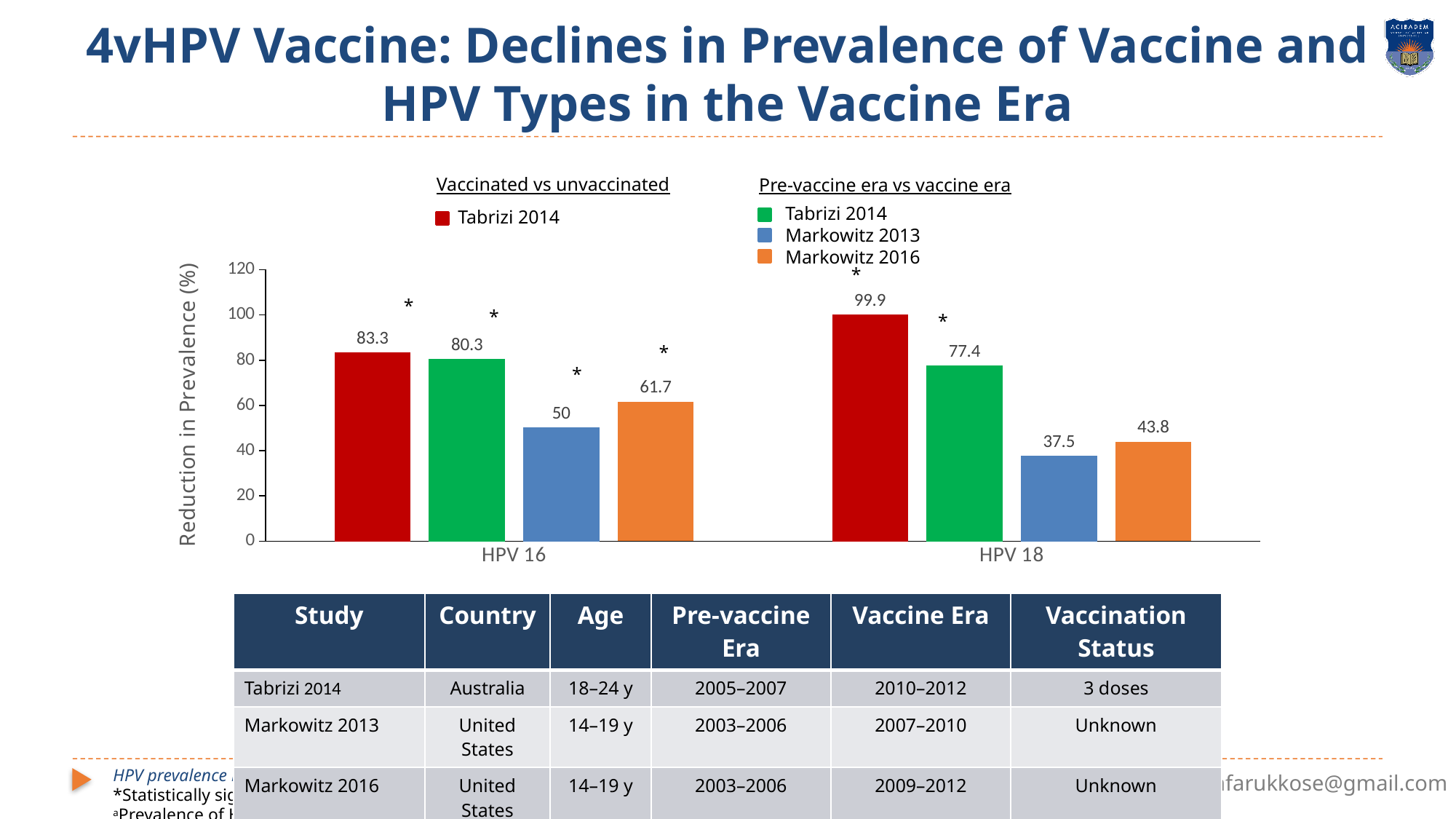
What is the reduction in prevalence for HPV 18 in the red Tabrizi 2014 (vaccinated vs unvaccinated) series? 99.9 How many categories are shown on the x axis? 2 What kind of chart is shown on the slide? bar chart What is the reduction in prevalence for HPV 16 in the Markowitz 2013 series? 50 Which series has the highest reduction in prevalence for HPV 18? Tabrizi 2014 (vaccinated vs unvaccinated) What is the difference between the red Tabrizi 2014 values for HPV 18 and HPV 16? 16.6 Is the Markowitz 2013 value for HPV 18 larger or smaller than the Markowitz 2016 value for HPV 18? smaller What is the reduction in prevalence for HPV 18 in the Markowitz 2016 series? 43.8 What is the reduction in prevalence for HPV 16 in the green Tabrizi 2014 (pre-vaccine era vs vaccine era) series? 80.3 How many series does the legend list? 4 What is the difference between the Markowitz 2016 and Markowitz 2013 values for HPV 16? 11.7 Which series has the lowest reduction in prevalence for HPV 16? Markowitz 2013